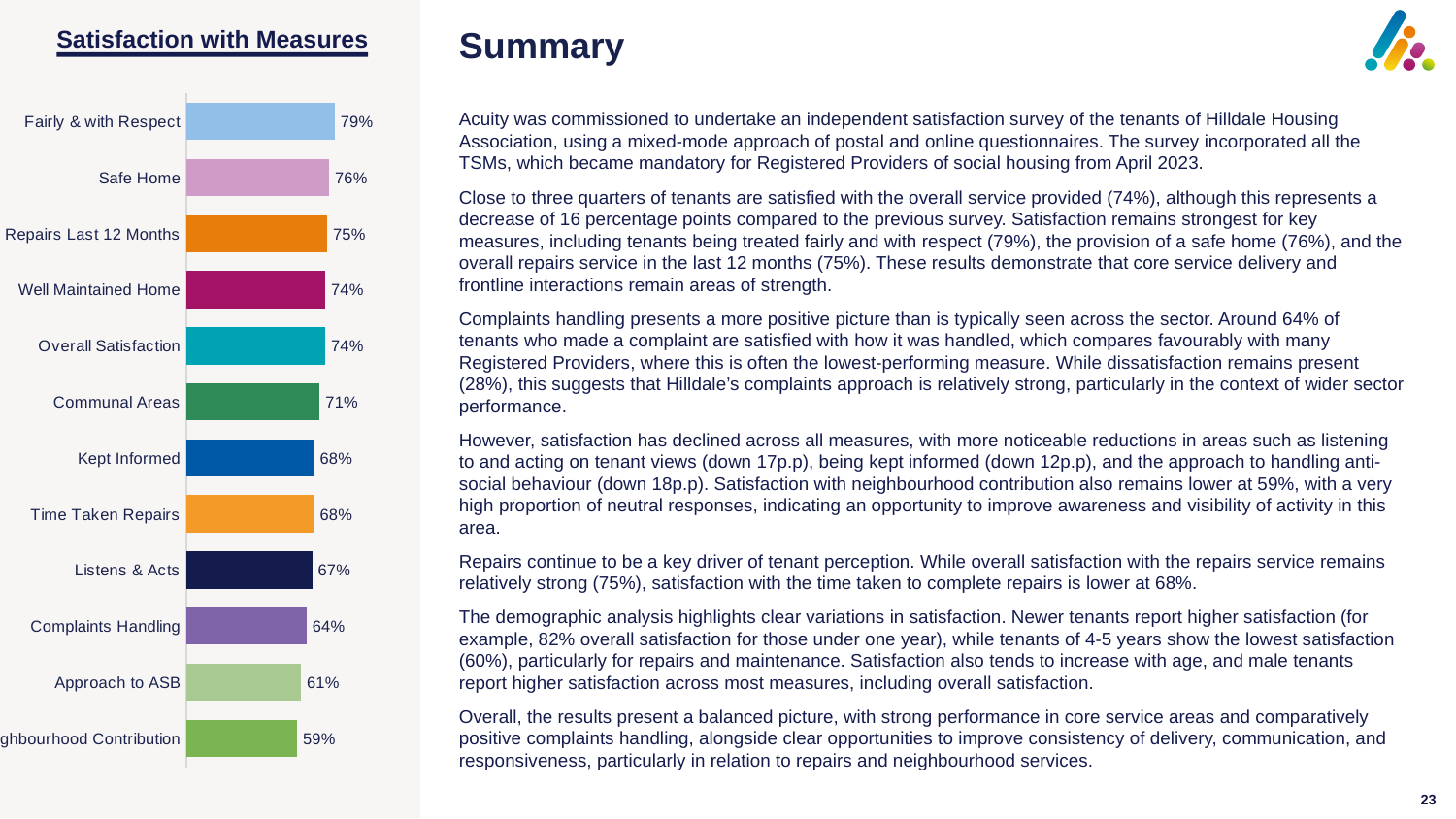
In the 'Satisfaction with Measures' chart, what is the value for Approach to ASB? 61% In the 'Satisfaction with Measures' chart, what is the lowest value shown? 59% What is the title of the bar chart on the left of the slide? Satisfaction with Measures In the 'Satisfaction with Measures' chart, what is the difference between Kept Informed and Listens & Acts? 1% In the 'Satisfaction with Measures' chart, what is the value for Overall Satisfaction? 74% In the 'Satisfaction with Measures' chart, which is higher: Repairs Last 12 Months or Time Taken Repairs? Repairs Last 12 Months In the 'Satisfaction with Measures' chart, what is the value for Complaints Handling? 64% In the 'Satisfaction with Measures' chart, what is the value for Fairly & with Respect? 79% How many measures (bars) are shown in the 'Satisfaction with Measures' chart? 12 What type of chart is shown under the title 'Satisfaction with Measures'? bar chart In the 'Satisfaction with Measures' chart, what is the difference between Safe Home and Approach to ASB? 15% In the 'Satisfaction with Measures' chart, which measure has the highest satisfaction? Fairly & with Respect